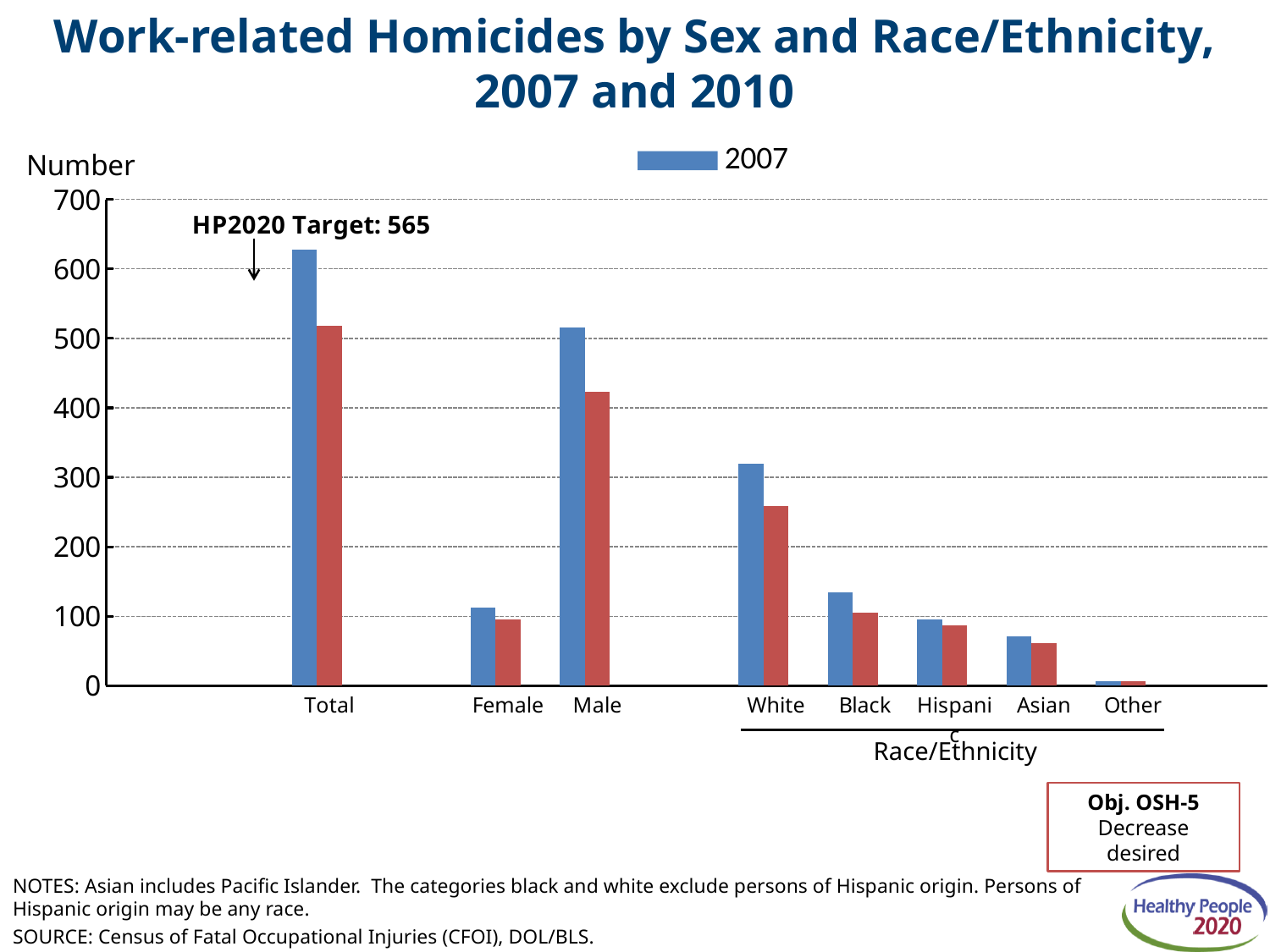
Which category has the lowest bars? Other Which category has the highest bars? Total Which has the larger 2007 value, Male or Female? Male How many categories are shown along the x axis? 8 Is the 2007 value for Asian greater or less than 100? less Is the 2007 value for White greater or less than 300? greater What is the label on the vertical axis? Number Is the 2007 value for Male greater or less than 400? greater What kind of chart is shown on the slide? bar chart What is the HP2020 Target value shown on the chart? 565 Which has the larger 2007 value, White or Black? White